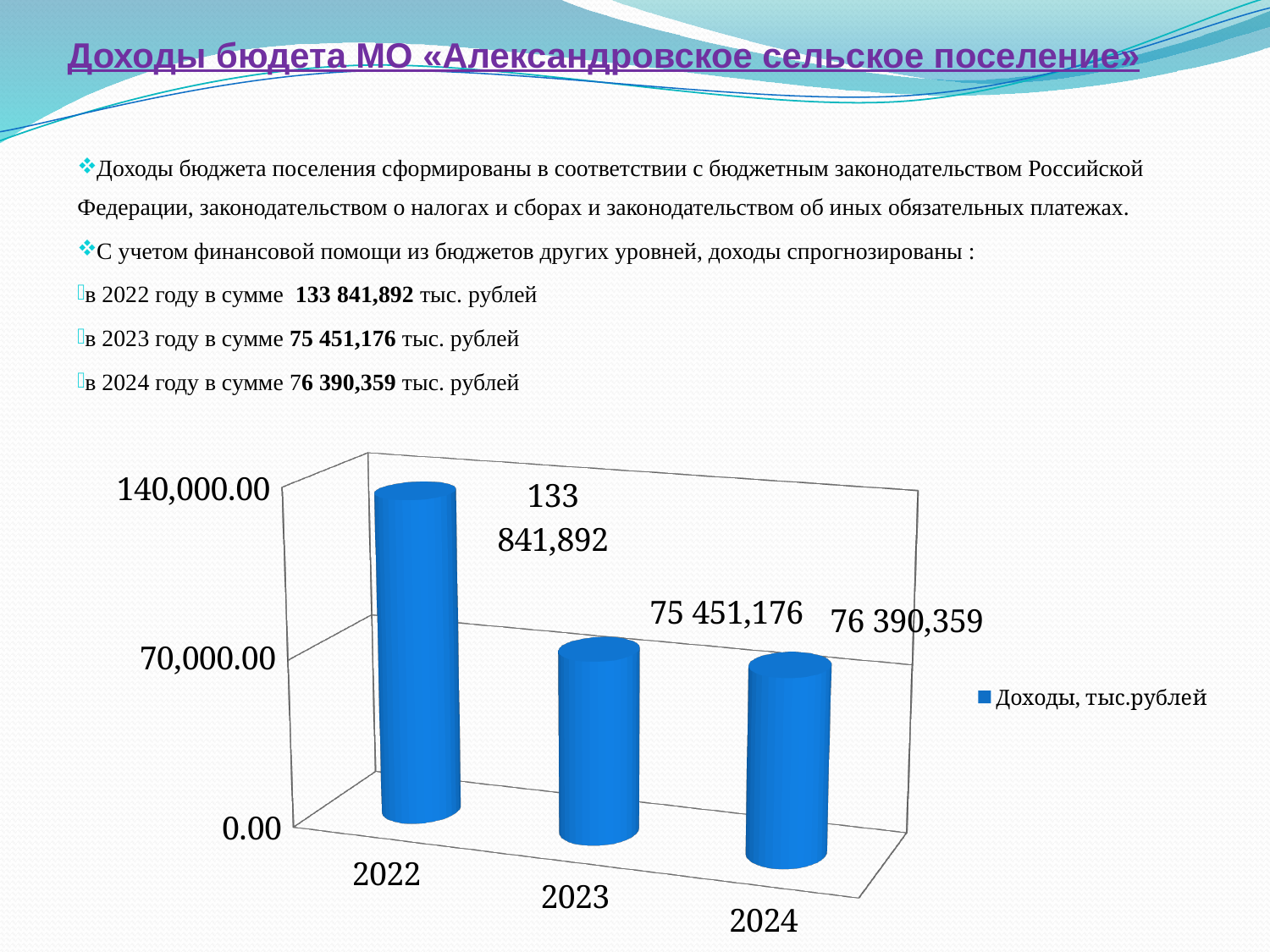
What kind of chart is shown on the slide? bar chart Which year has the highest value in the chart? 2022 Which year has the lowest value in the chart? 2023 What is the difference between the values for 2022 and 2023? 58 390,716 How many years are shown in the chart? 3 What is the value for 2024 in the chart? 76 390,359 What is the legend entry of the chart? Доходы, тыс.рублей Which is larger, the value for 2022 or the value for 2024? 2022 What is the value for 2023 in the chart? 75 451,176 How many series does the legend list? 1 What is the value for 2022 in the chart? 133 841,892 Is the value for 2022 greater or less than 70,000.00? greater